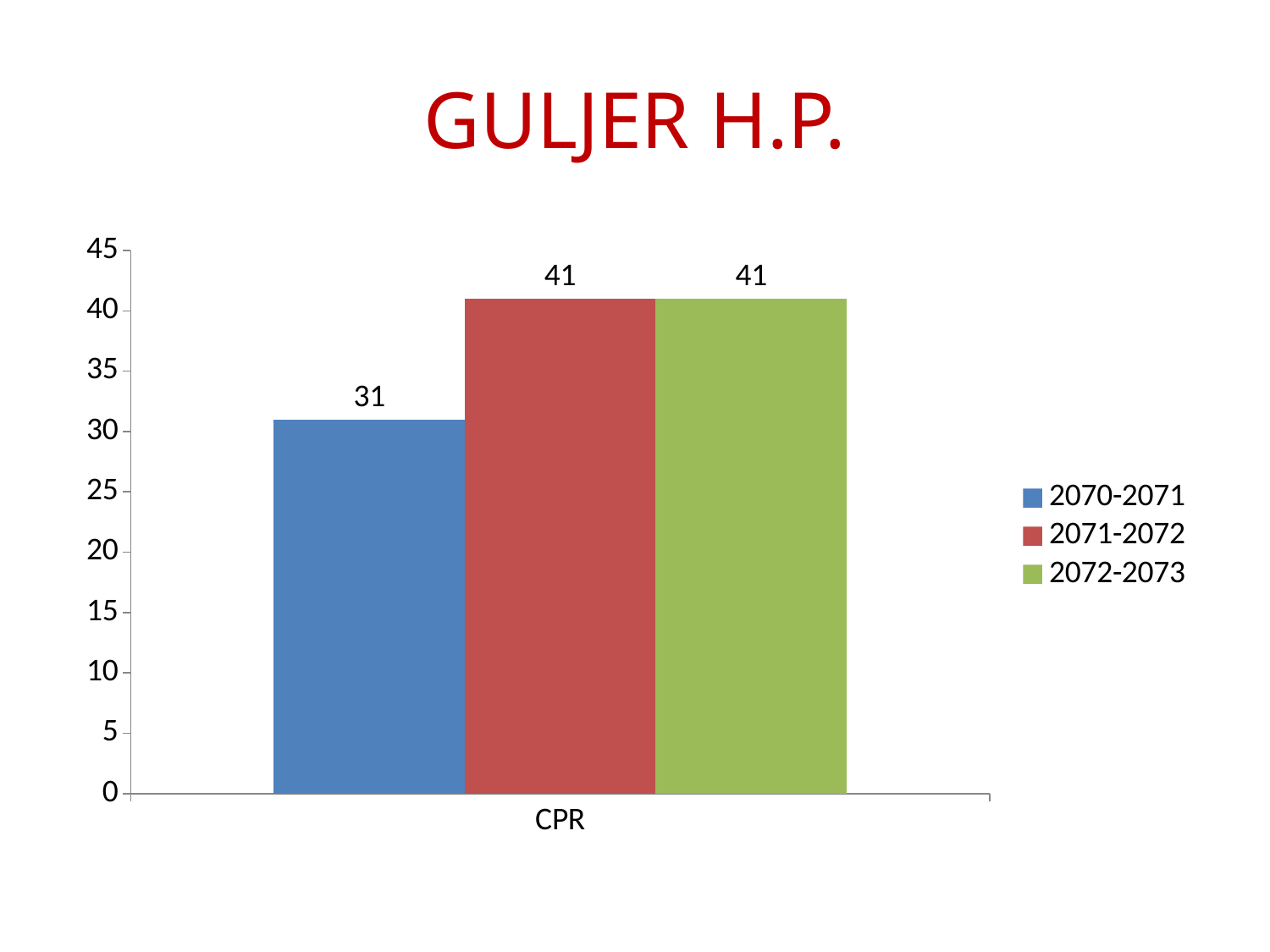
What is the CPR value for 2071-2072? 41 What is the difference between the CPR values for 2071-2072 and 2070-2071? 10 What is the CPR value for 2070-2071? 31 What kind of chart is shown on the slide? bar chart How many series does the legend list? 3 What is the title of the slide? GULJER H.P. Which series has the lowest CPR value? 2070-2071 Is the CPR value for 2071-2072 greater or less than 40? greater Which is larger, the CPR value for 2070-2071 or for 2072-2073? 2072-2073 Is the CPR value for 2070-2071 greater or less than 35? less What is the CPR value for 2072-2073? 41 What is the category label on the x axis? CPR